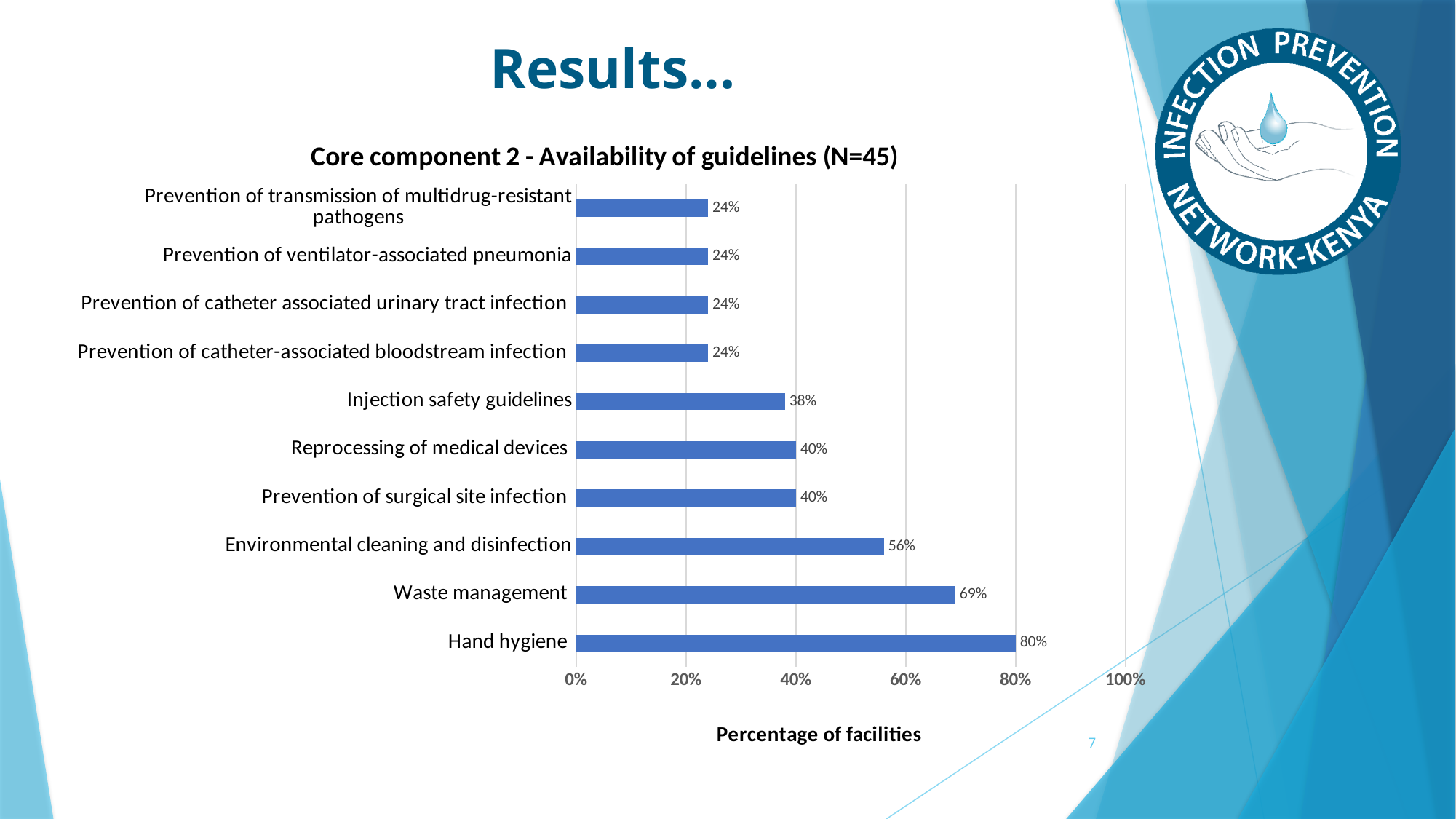
How many categories are shown in the chart? 10 Which category has the highest percentage of facilities? Hand hygiene What is the difference between the values for Environmental cleaning and disinfection and Prevention of surgical site infection? 16% What is the value for Environmental cleaning and disinfection? 56% Which is larger, the value for Reprocessing of medical devices or the value for Injection safety guidelines? Reprocessing of medical devices What is the title of the chart? Core component 2 - Availability of guidelines (N=45) What percentage of facilities had hand hygiene guidelines available? 80% What percentage of facilities had injection safety guidelines? 38% What is the value for Waste management? 69% Is the value for Waste management greater or less than 60%? greater What is the difference between the values for Hand hygiene and Waste management? 11% What kind of chart is shown on the slide? Bar chart